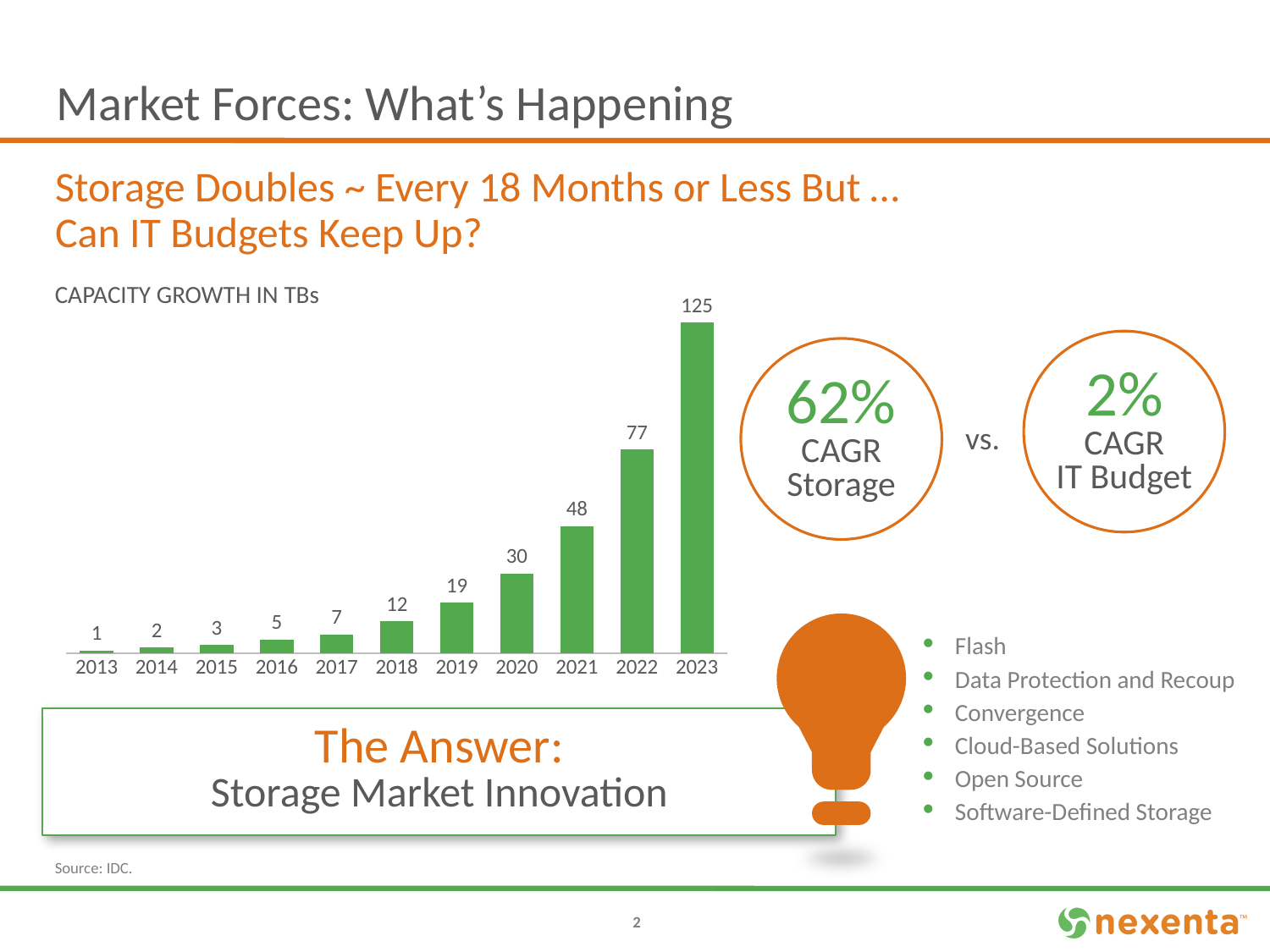
What kind of chart is used to show capacity growth? Bar chart Do the capacity values rise or fall from 2013 to 2023? Rise What is the title of the chart? CAPACITY GROWTH IN TBs Which year has the highest capacity value? 2023 How many years are shown on the x axis of the chart? 11 What is the capacity value shown for 2016? 5 What is the difference between the capacity values for 2021 and 2020? 18 Which year has a larger capacity value, 2018 or 2020? 2020 What is the difference between the capacity values for 2023 and 2022? 48 Which year has the lowest capacity value? 2013 What is the capacity value shown for 2019? 19 What is the capacity value shown for 2023? 125